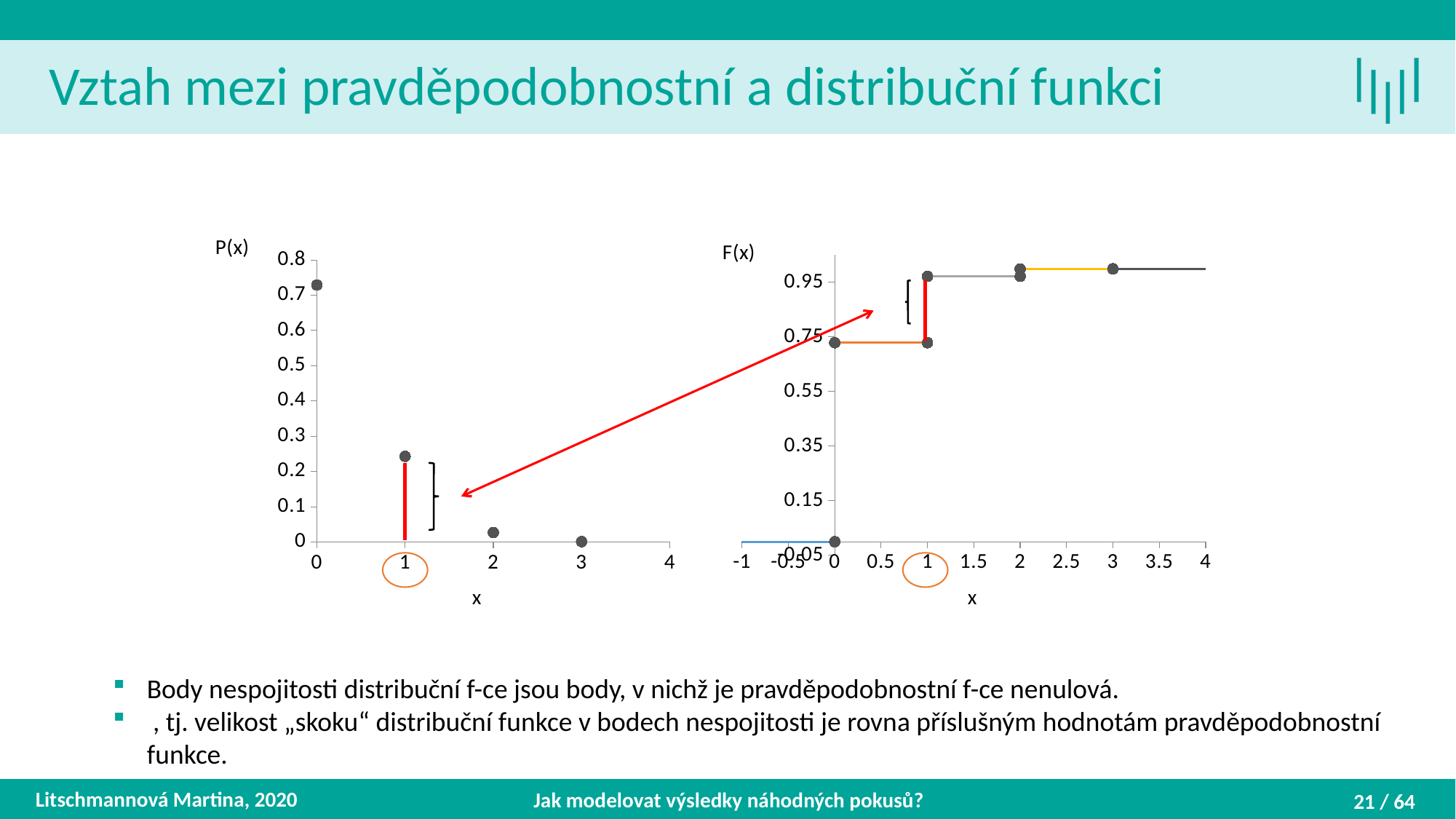
On the right chart (F(x)), which is larger: the value at x = 0 or the value at x = 1? x = 1 What is the label of the vertical axis on the right chart? F(x) What is the label of the horizontal axis on the left chart? x On the right chart (F(x)), do the values rise or fall as x increases? rise On the left chart (P(x)), is the value at x = 0 greater or less than 0.6? greater On the left chart (P(x)), is the value at x = 1 greater or less than 0.3? less On the left chart (P(x)), how many data points are plotted? 4 On the left chart (P(x)), is the value at x = 2 greater or less than 0.1? less On the left chart (P(x)), which is larger: the value at x = 0 or the value at x = 1? x = 0 On the left chart (P(x)), at which value of x is the plotted probability highest? 0